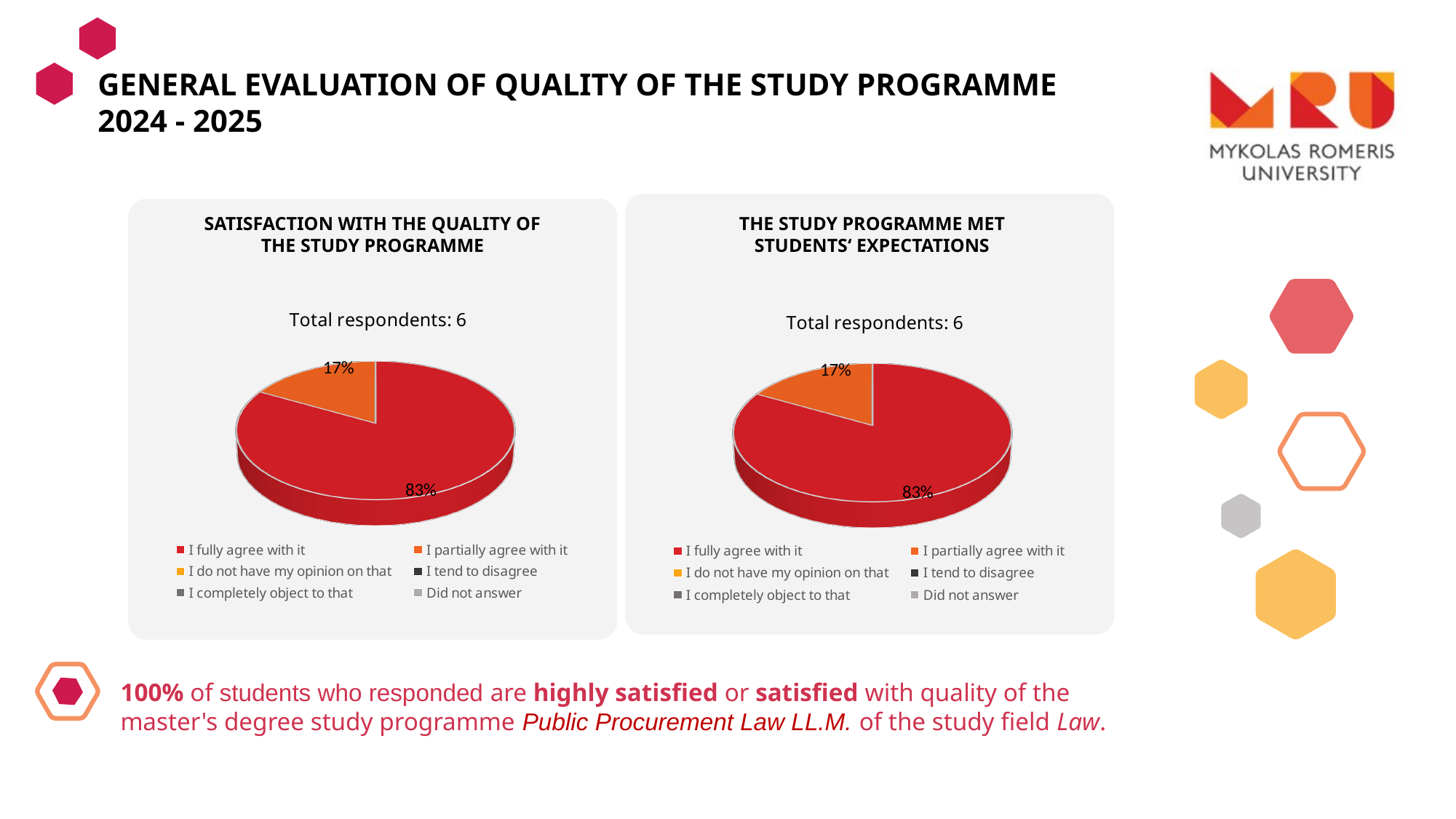
In the 'Satisfaction with the quality of the study programme' chart, what colour is the 'I fully agree with it' slice? Red In the 'The study programme met students' expectations' chart, what share of respondents chose 'I partially agree with it'? 17% How many legend entries are listed for the 'The study programme met students' expectations' chart? 6 In the 'The study programme met students' expectations' chart, which response has the smallest visible slice? I partially agree with it In the 'The study programme met students' expectations' chart, which is larger: 'I fully agree with it' or 'I partially agree with it'? I fully agree with it How many total respondents are reported for the 'Satisfaction with the quality of the study programme' chart? 6 In the 'Satisfaction with the quality of the study programme' chart, what share of respondents chose 'I partially agree with it'? 17% In the 'Satisfaction with the quality of the study programme' chart, what share of respondents chose 'I fully agree with it'? 83% What type of chart is used in the 'Satisfaction with the quality of the study programme' panel? Pie chart In the 'The study programme met students' expectations' chart, what share of respondents chose 'I fully agree with it'? 83% In the 'Satisfaction with the quality of the study programme' chart, what is the difference between the 'I fully agree with it' and 'I partially agree with it' shares? 66% In the 'Satisfaction with the quality of the study programme' chart, which response has the largest slice? I fully agree with it